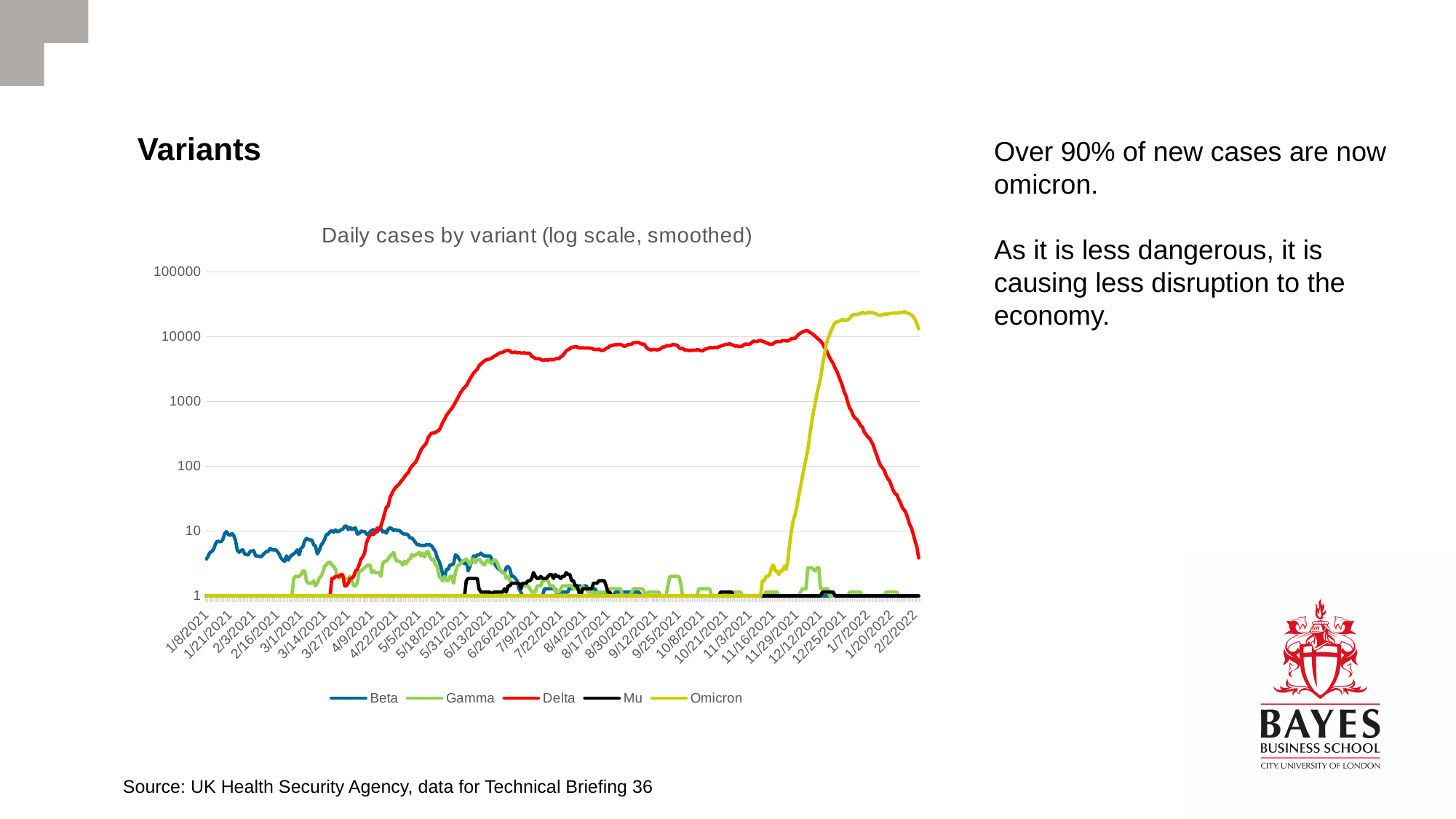
Which variant's line reaches the highest value on the chart? Omicron Is the peak value for Omicron greater or less than 10000? greater What kind of chart is shown on the slide? Line chart What is the title of the chart? Daily cases by variant (log scale, smoothed) Does the Delta line rise or fall between 3/27/2021 and 6/26/2021? rise Is the value for Delta around 8/4/2021 greater or less than 1000? greater How many series does the legend list? 5 Is the peak value for Beta greater or less than 100? less Around 1/8/2021, which is higher, Beta or Delta? Beta On 2/2/2022, which is higher, Delta or Omicron? Omicron What colour is the Delta line? Red